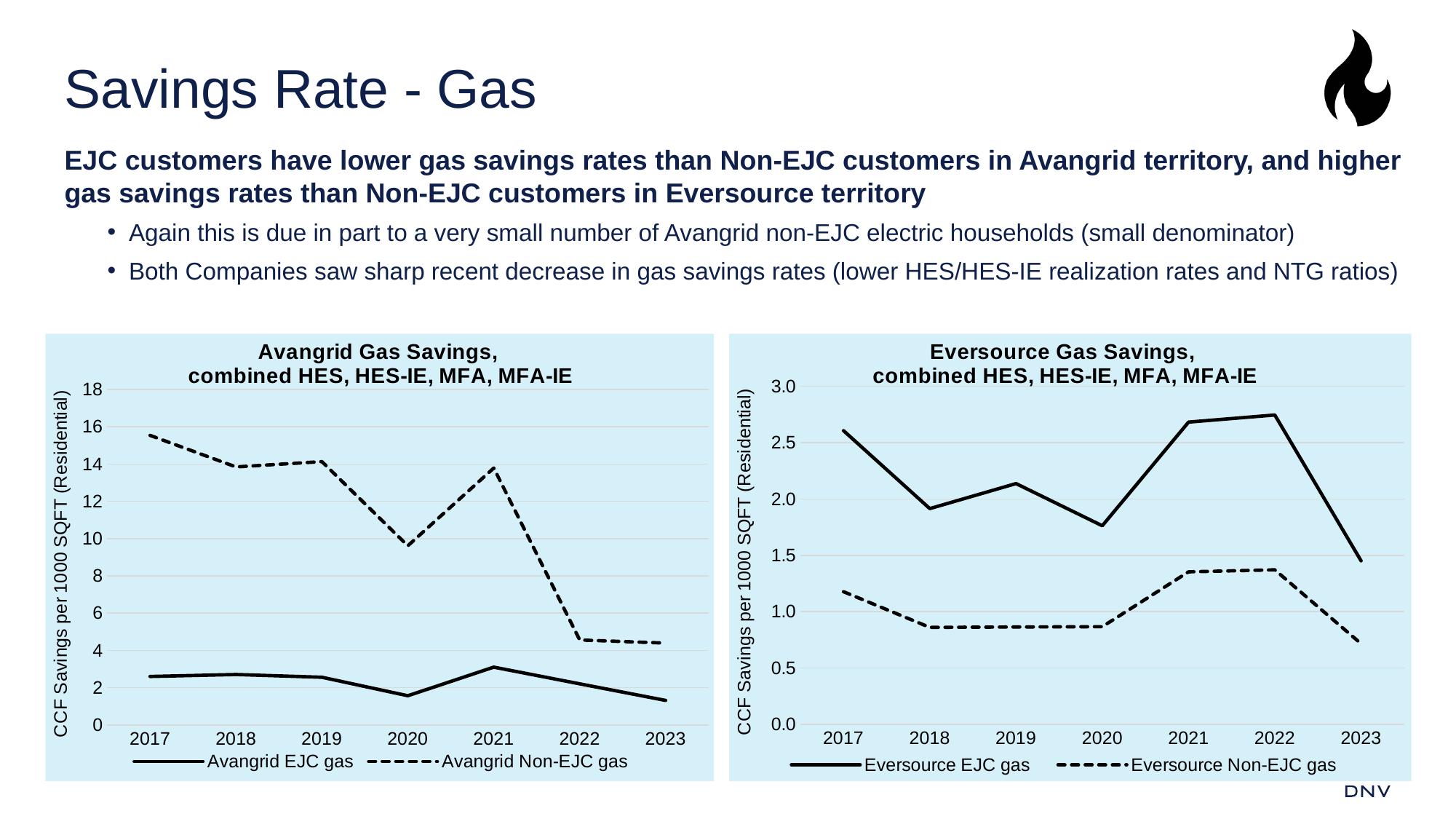
What type of chart is the Avangrid Gas Savings chart on the left? line chart How many years are plotted on the x axis of the Avangrid Gas Savings chart? 7 In the Avangrid Gas Savings chart, which series has the larger value in 2021, Avangrid EJC gas or Avangrid Non-EJC gas? Avangrid Non-EJC gas In the Eversource Gas Savings chart, which year has the lowest value for Eversource Non-EJC gas? 2023 In the Avangrid Gas Savings chart, is the value for Avangrid Non-EJC gas in 2017 greater or less than 14? greater In the Eversource Gas Savings chart, is the value for Eversource EJC gas in 2022 greater or less than 2.5? greater In the Avangrid Gas Savings chart, does the Avangrid Non-EJC gas line rise or fall from 2021 to 2023? fall In the Eversource Gas Savings chart, which series has the larger value in 2017, Eversource EJC gas or Eversource Non-EJC gas? Eversource EJC gas In the Avangrid Gas Savings chart, which year has the highest value for Avangrid Non-EJC gas? 2017 In the Avangrid Gas Savings chart, is the value for Avangrid Non-EJC gas in 2022 greater or less than 6? less How many series does the legend of the Eversource Gas Savings chart list? 2 In the Eversource Gas Savings chart, which year has the lowest value for Eversource EJC gas? 2023